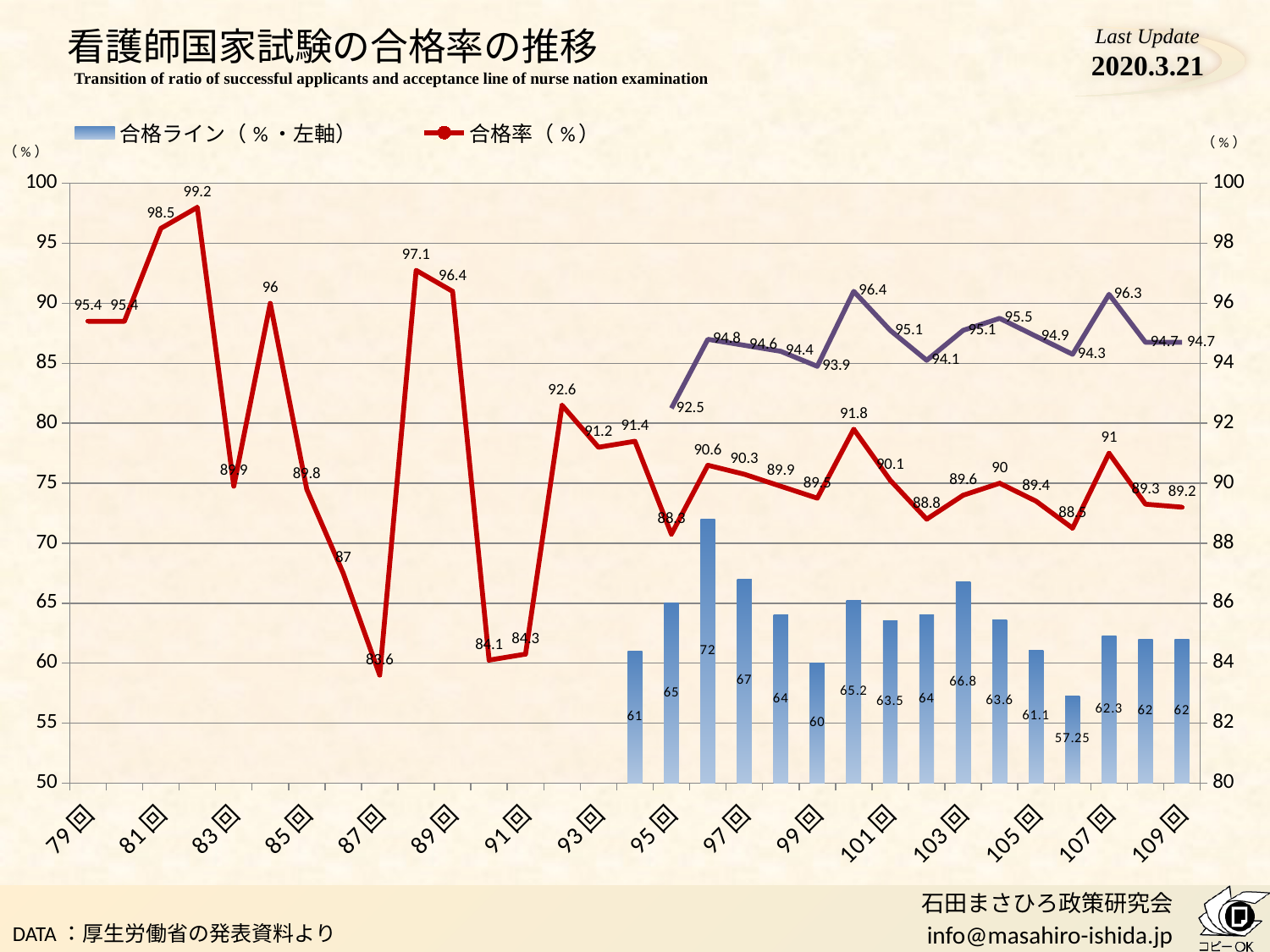
How many 合格ライン bars are plotted on the chart? 16 What is the highest value reached by the 合格率 (red) line? 99.2 What is the value of the tallest 合格ライン bar? 72 Is the 合格ライン bar value at 109回 greater or less than 60? greater Which has the higher 合格率 value, 107回 or 109回? 107回 What kind of chart is shown on the slide? A combined bar and line chart What is the value of the shortest 合格ライン bar? 57.25 What is the 合格率 value at 109回? 89.2 What is the lowest value reached by the 合格率 (red) line? 83.6 What is the difference between the 合格率 values at 81回 (98.5) and 82回 (99.2)? 0.7 What is the 合格率 value at 79回? 95.4 How many series does the legend list? 2